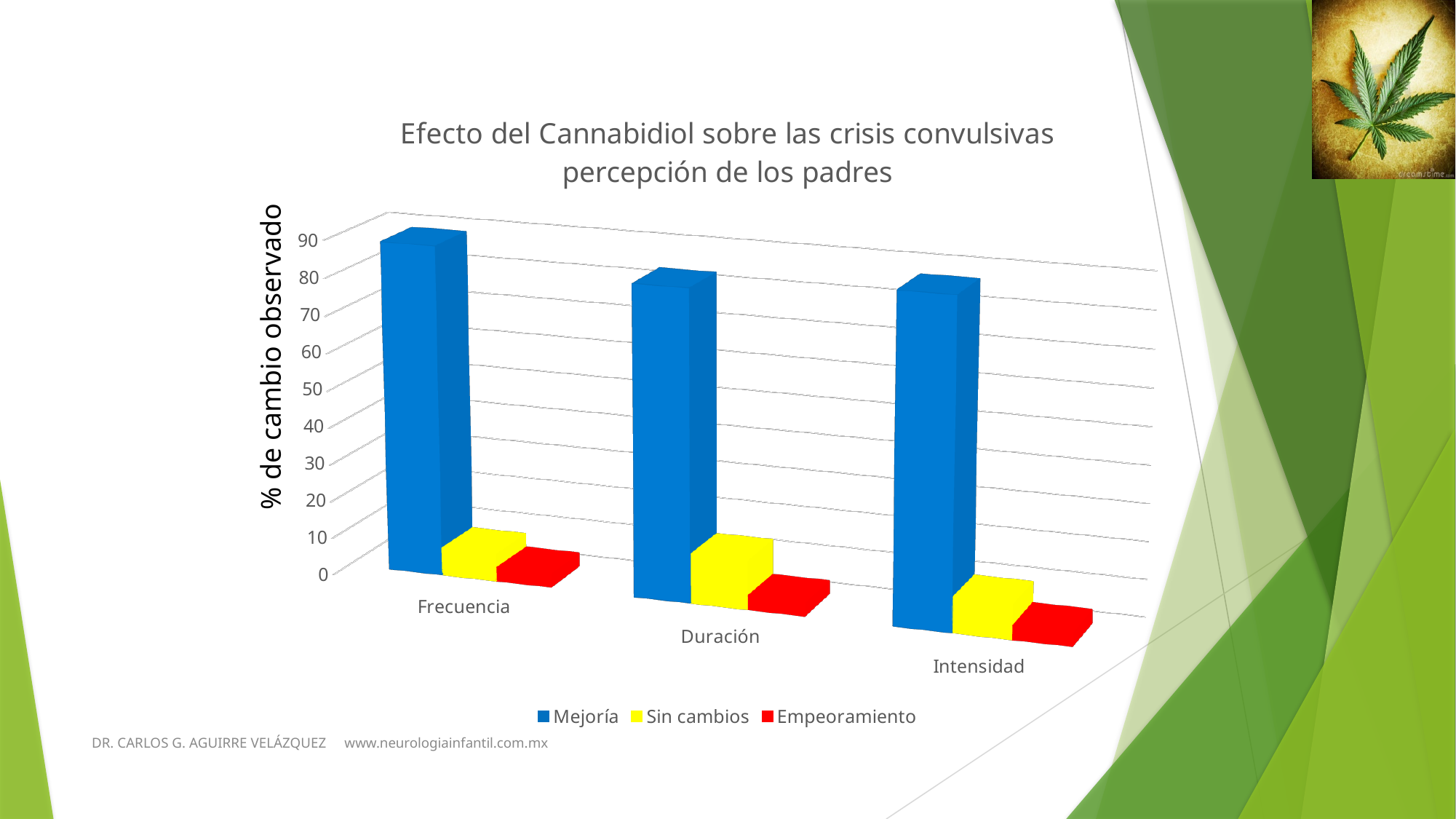
What is the title of the chart? Efecto del Cannabidiol sobre las crisis convulsivas percepción de los padres Is the Sin cambios value for Frecuencia greater or less than 20? less Is the Empeoramiento value for Duración greater or less than 20? less Does the Mejoría series rise or fall from Frecuencia to Intensidad? fall For Duración, which is larger: Mejoría or Sin cambios? Mejoría Is the Mejoría value for Frecuencia greater or less than 50? greater Which category has the highest value for the Mejoría series? Frecuencia What is the label of the vertical axis of the chart? % de cambio observado How many series does the chart legend list? 3 What kind of chart is shown on the slide? bar chart How many categories are shown on the x axis of the chart? 3